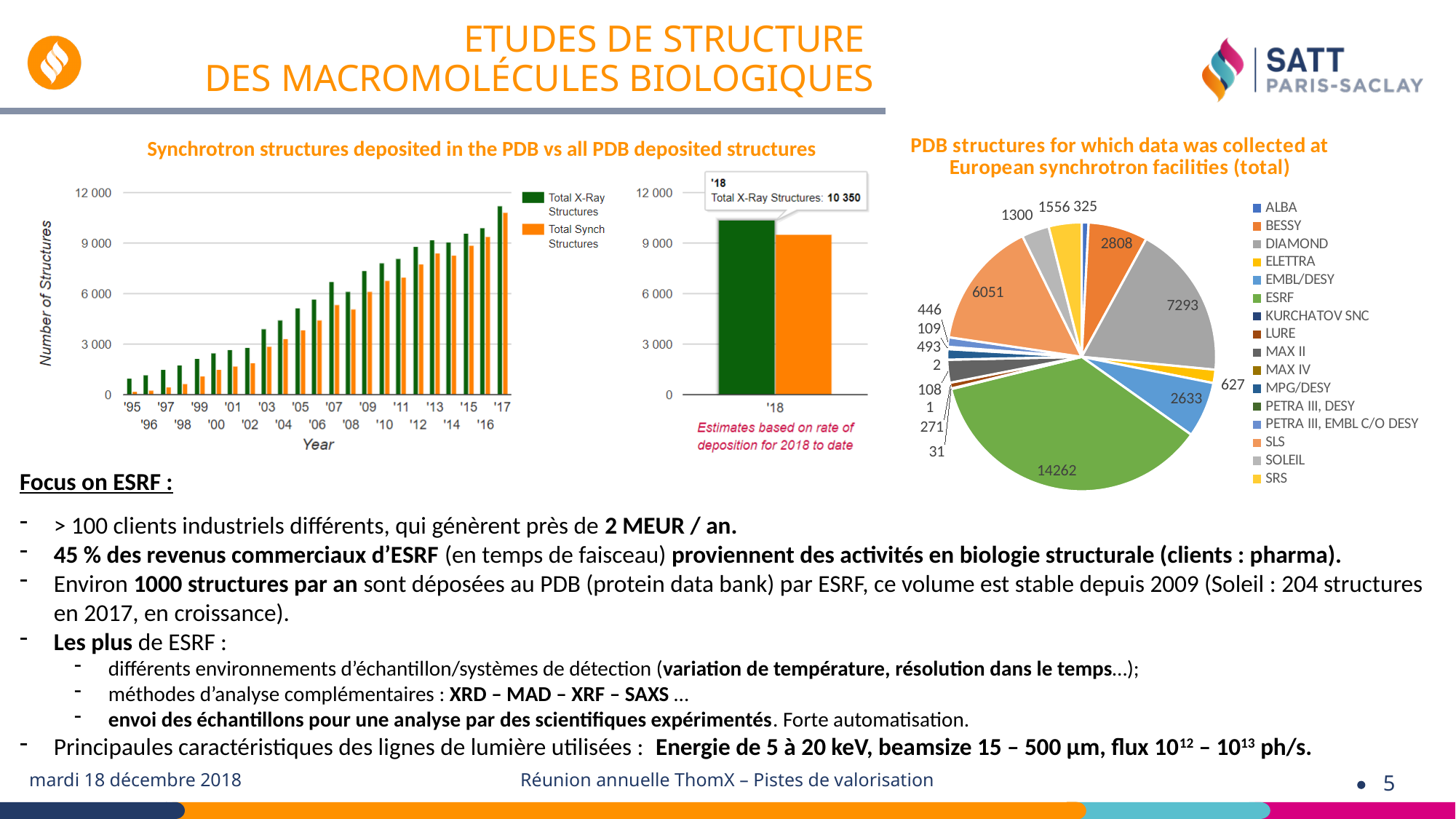
In the pie chart 'PDB structures for which data was collected at European synchrotron facilities (total)', which facility has the largest slice? ESRF In the pie chart 'PDB structures for which data was collected at European synchrotron facilities (total)', what is the value for DIAMOND? 7293 In the 'Synchrotron structures deposited in the PDB vs all PDB deposited structures' chart, how many series does the legend list? 2 What kind of chart is 'PDB structures for which data was collected at European synchrotron facilities (total)'? pie chart In the 'Synchrotron structures deposited in the PDB vs all PDB deposited structures' chart, is the Total Synch Structures value for '05 greater or less than 6 000? less In the pie chart 'PDB structures for which data was collected at European synchrotron facilities (total)', what is the value for ESRF? 14262 What kind of chart is the 'Synchrotron structures deposited in the PDB vs all PDB deposited structures' chart on the left? bar chart In the pie chart 'PDB structures for which data was collected at European synchrotron facilities (total)', how many facilities does the legend list? 16 In the small bar chart for '18 in the middle of the slide, what is the Total X-Ray Structures value shown in the tooltip? 10 350 In the 'Synchrotron structures deposited in the PDB vs all PDB deposited structures' chart, is the Total X-Ray Structures value for '17 greater or less than 9 000? greater In the pie chart 'PDB structures for which data was collected at European synchrotron facilities (total)', what is the difference between the ESRF value and the DIAMOND value? 6969 In the 'Synchrotron structures deposited in the PDB vs all PDB deposited structures' chart, do the Total X-Ray Structures values rise or fall from '95 to '17? rise